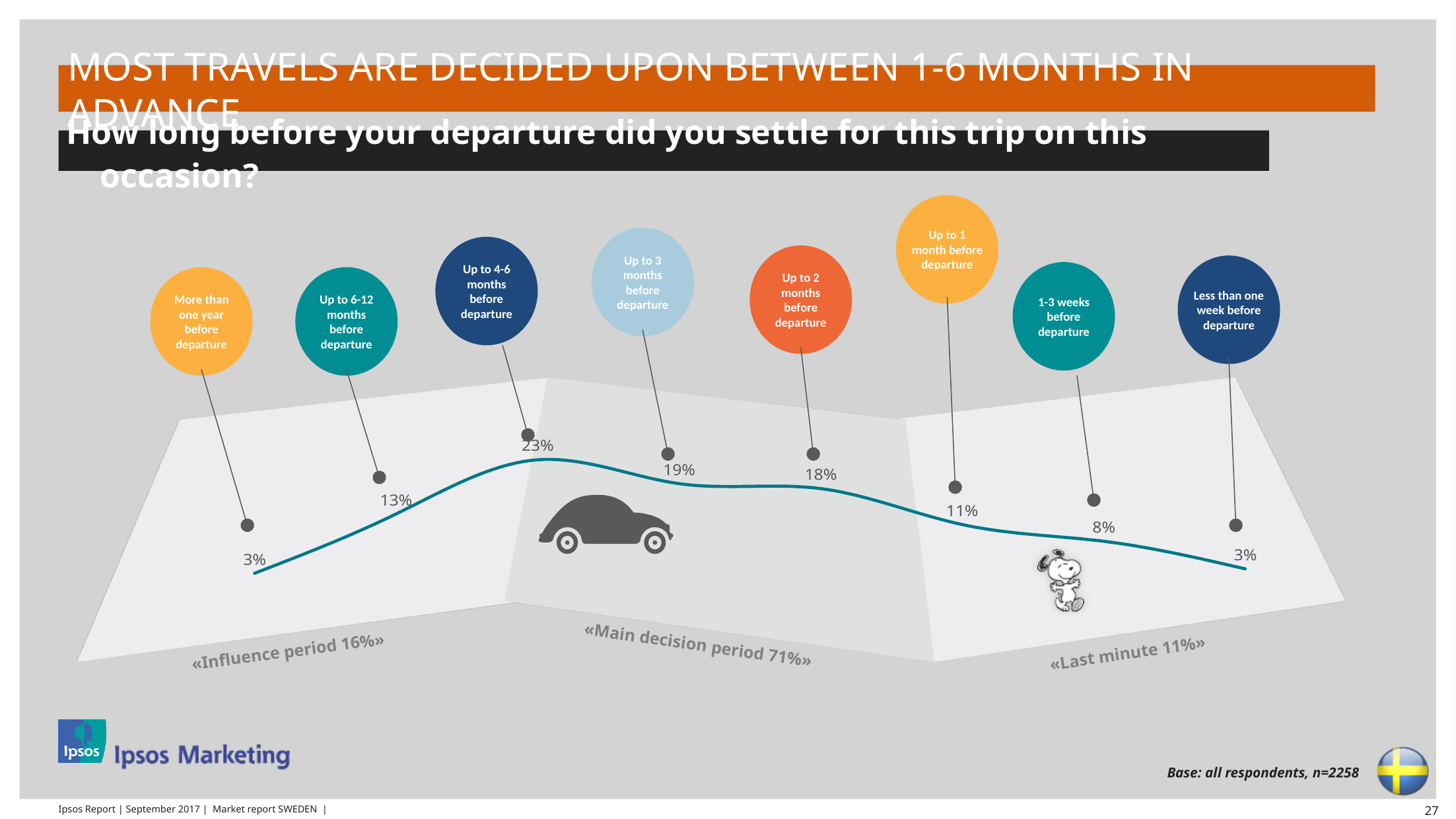
What is the difference between the values for 'Up to 4-6 months before departure' and 'Up to 6-12 months before departure'? 10% What percentage is given for the 'Main decision period' label on the chart? 71% Which category has the highest percentage? Up to 4-6 months before departure Do the values rise or fall from 'Up to 4-6 months before departure' to 'Less than one week before departure'? Fall What percentage of respondents settled for the trip up to 4-6 months before departure? 23% What percentage is shown for '1-3 weeks before departure'? 8% What is the difference between the values for 'Up to 3 months before departure' and 'Up to 2 months before departure'? 1% What kind of chart is used to show the percentages? Line chart What is the value shown for 'Up to 6-12 months before departure'? 13% How many categories (time periods) are plotted on the chart? 8 What is the value for 'Up to 1 month before departure'? 11% Which is larger, the value for 'Up to 1 month before departure' or the value for '1-3 weeks before departure'? Up to 1 month before departure